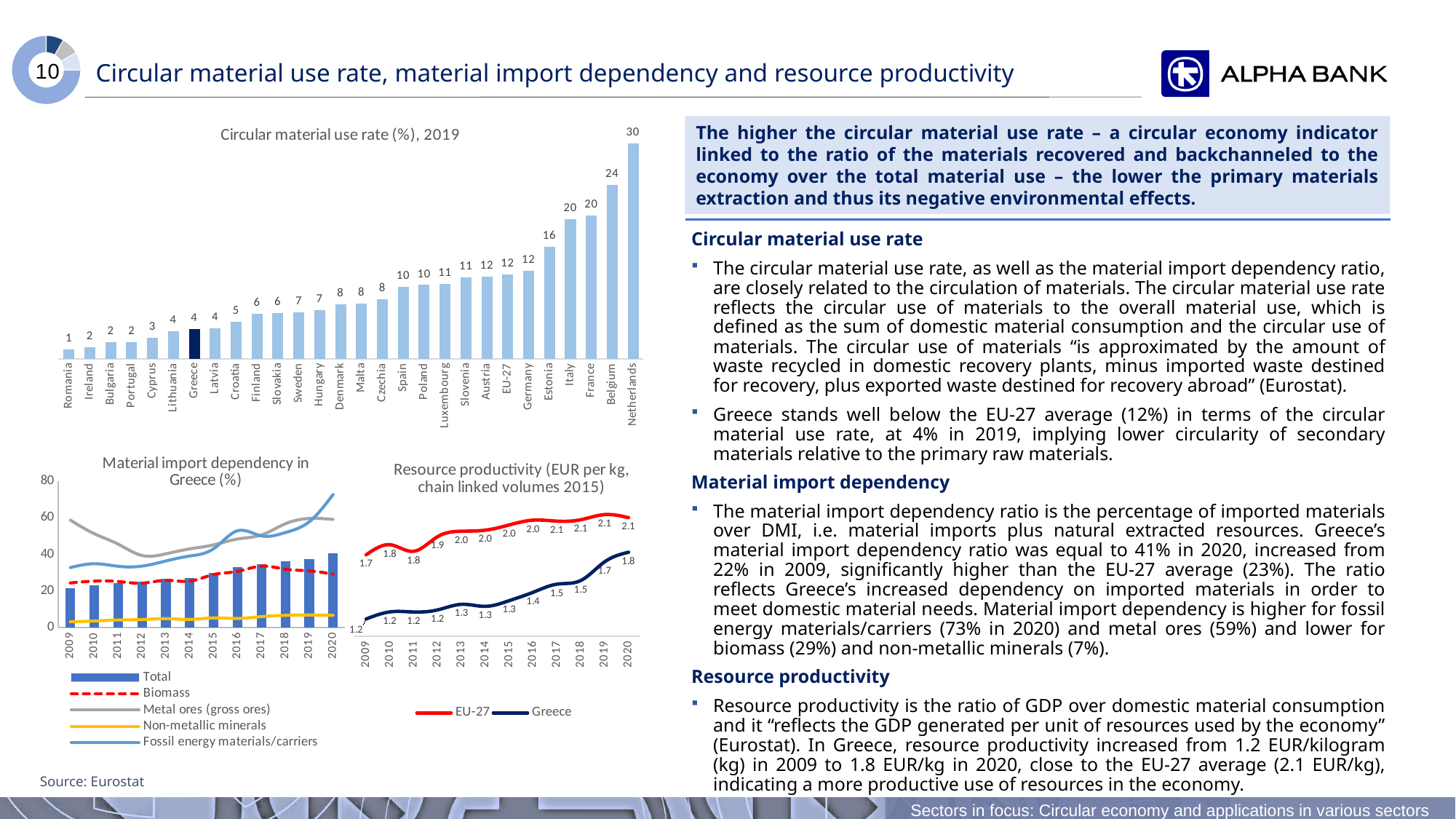
In the 'Circular material use rate (%), 2019' chart, which country has the highest value? Netherlands In the 'Resource productivity' chart, what is the value for EU-27 in 2009? 1.7 How many bars are shown in the 'Circular material use rate (%), 2019' chart? 28 How many series does the legend of the 'Material import dependency in Greece (%)' chart list? 5 What kind of chart is the 'Circular material use rate (%), 2019' chart? Bar chart In the 'Circular material use rate (%), 2019' chart, what is the difference between the values for the Netherlands and Belgium? 6 In the 'Circular material use rate (%), 2019' chart, which country has the lowest value? Romania In the 'Circular material use rate (%), 2019' chart, what is the value for the Netherlands? 30 In the 'Circular material use rate (%), 2019' chart, what is the value for Greece? 4 In the 'Circular material use rate (%), 2019' chart, which has the larger value, Estonia or Italy? Italy In the 'Resource productivity' chart, what is the value for Greece in 2020? 1.8 In the 'Material import dependency in Greece (%)' chart, is the value of the Fossil energy materials/carriers line in 2020 greater or less than 60? greater